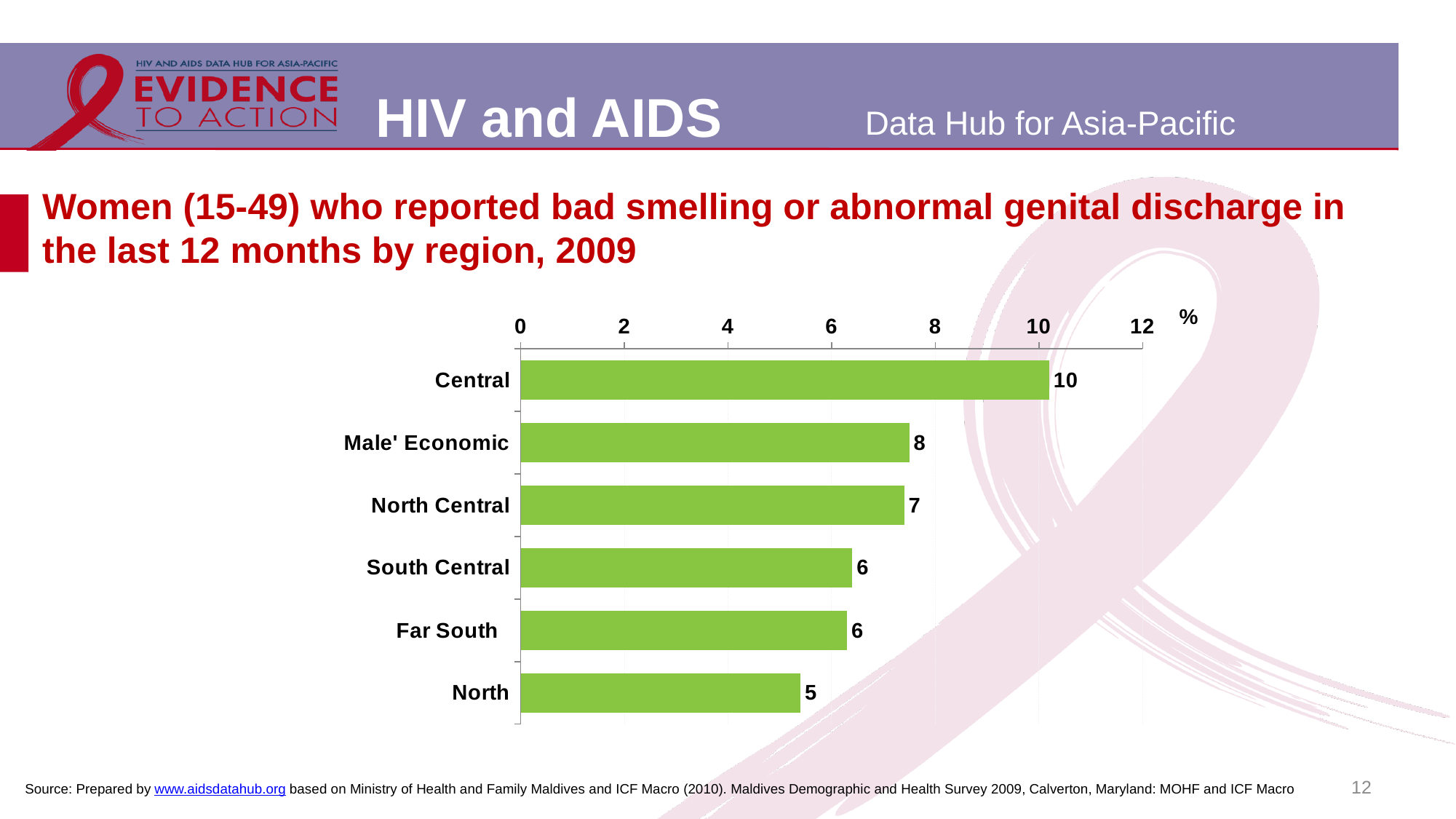
What type of chart is shown on the slide? Bar chart What is the value shown for Male' Economic? 8 Is the value for Central greater or less than 8? greater How many regions are shown in the chart? 6 What unit is indicated at the end of the horizontal axis? % What is the difference between the values for Central and North? 5 Which region has the lowest percentage of women reporting abnormal genital discharge? North What is the value shown for the North region? 5 What percentage of women in the Central region reported bad smelling or abnormal genital discharge? 10 Which has a higher value, Male' Economic or North Central? Male' Economic Which region has the highest percentage of women reporting abnormal genital discharge? Central What is the value shown for North Central? 7